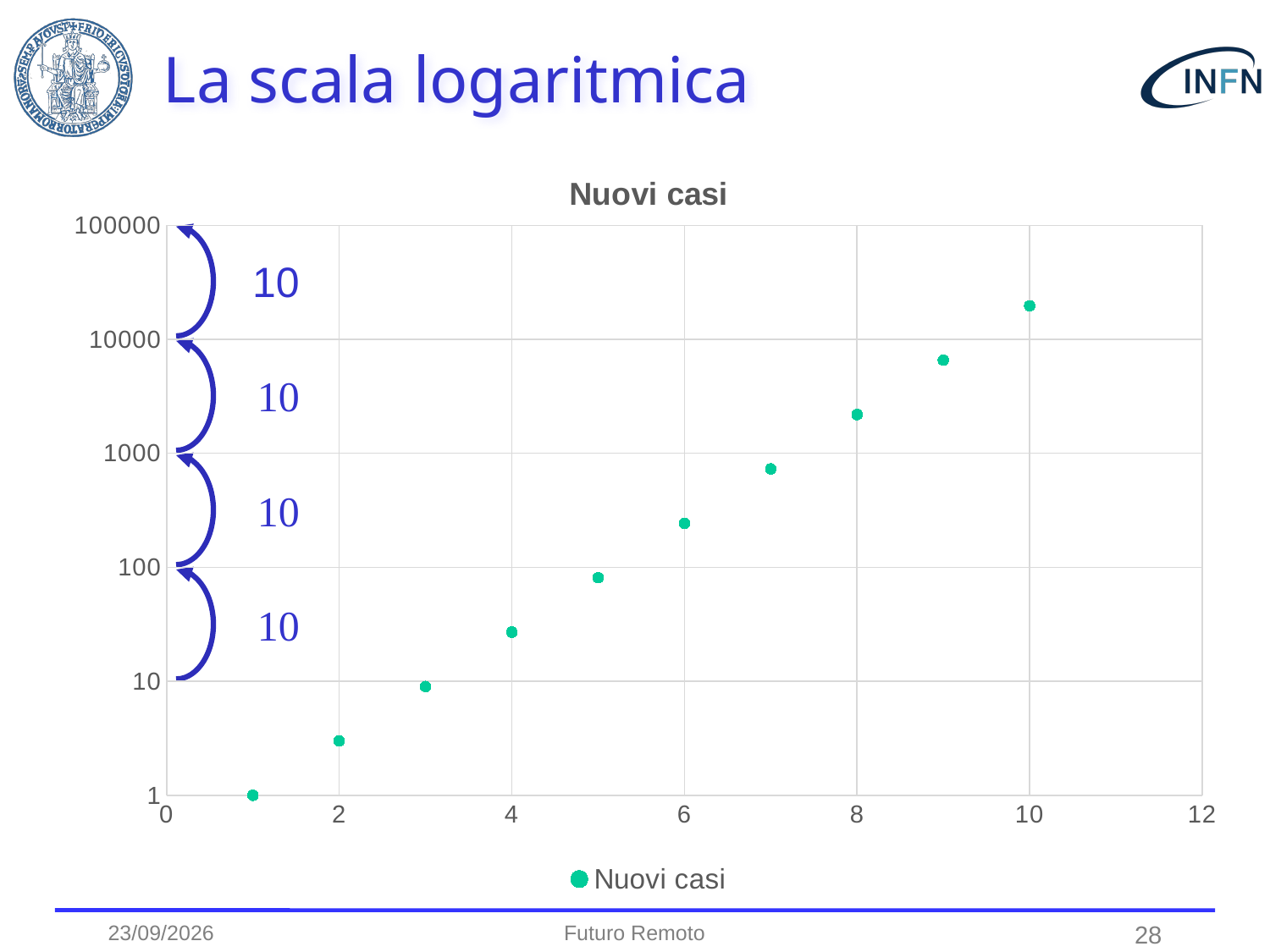
Is the value at x = 5 greater or less than 100? less Is the value at x = 9 greater or less than 10000? less What is the plotted value at x = 1? 1 At which x value is the plotted value highest? 10 Which is larger, the value at x = 7 or the value at x = 4? x = 7 Do the values rise or fall as x increases along the x axis? rise What is the title of the chart? Nuovi casi At which x value is the plotted value lowest? 1 Is the value at x = 10 greater or less than 10000? greater What kind of chart is shown on the slide? scatter chart How many series does the legend list? 1 How many data points are plotted in the chart? 10